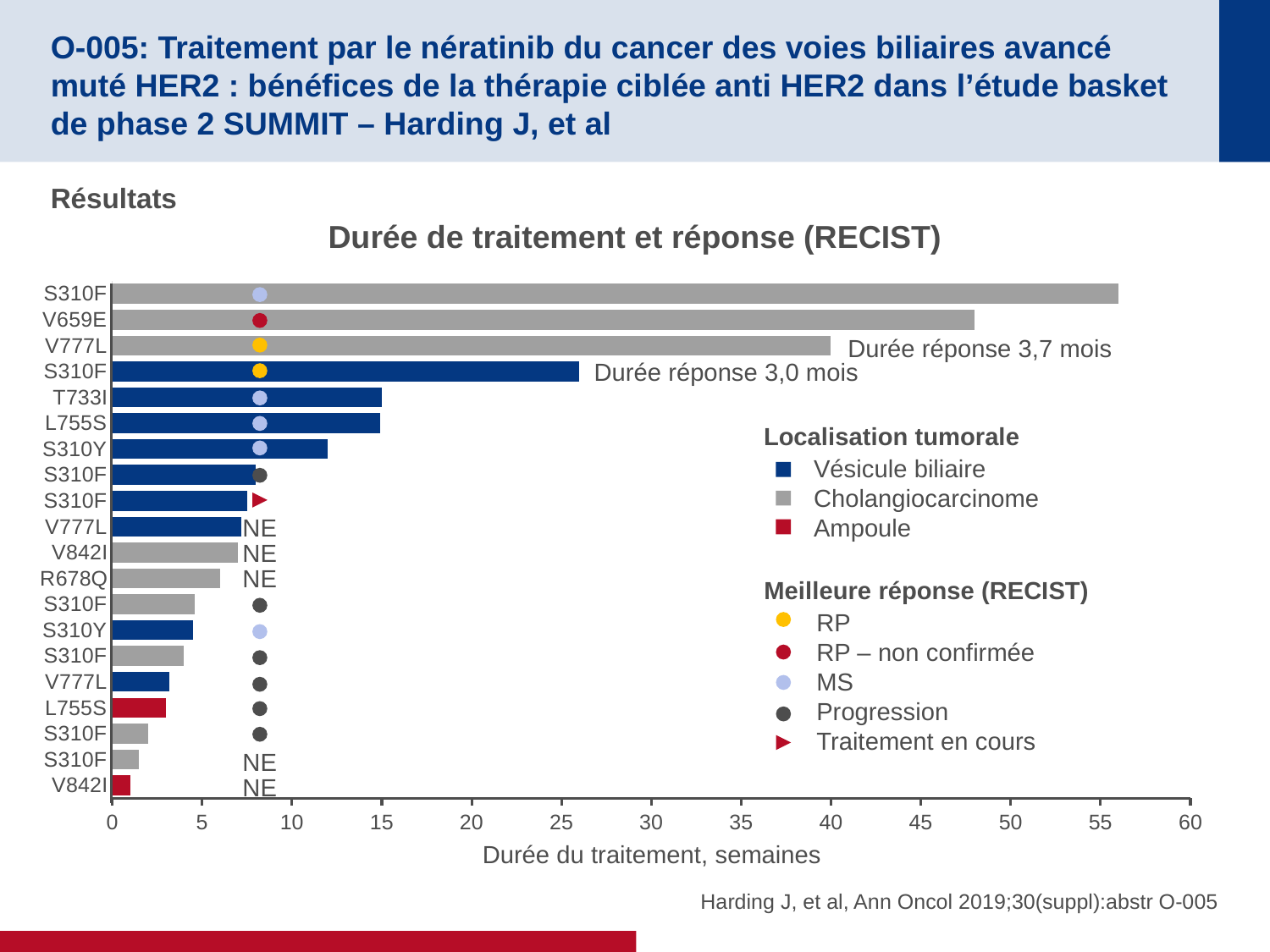
Which has the longer treatment duration, V659E or T733I? V659E Is the treatment duration for V659E greater or less than 45 weeks? greater How many patient bars are plotted in the chart? 20 What duration of response is annotated next to the fourth bar from the top (S310F)? 3,0 mois Is the treatment duration of the top S310F bar greater or less than 50 weeks? greater Is the treatment duration for the first S310Y bar (seventh from the top) greater or less than 10 weeks? greater What duration of response is annotated next to the V777L bar (third from the top)? 3,7 mois Which patient has the longest treatment duration in the chart? S310F (top bar) Which patient has the shortest treatment duration in the chart? V842I (bottom bar) What is the title of the x axis of the chart? Durée du traitement, semaines What kind of chart is shown on the slide? Bar chart (horizontal)